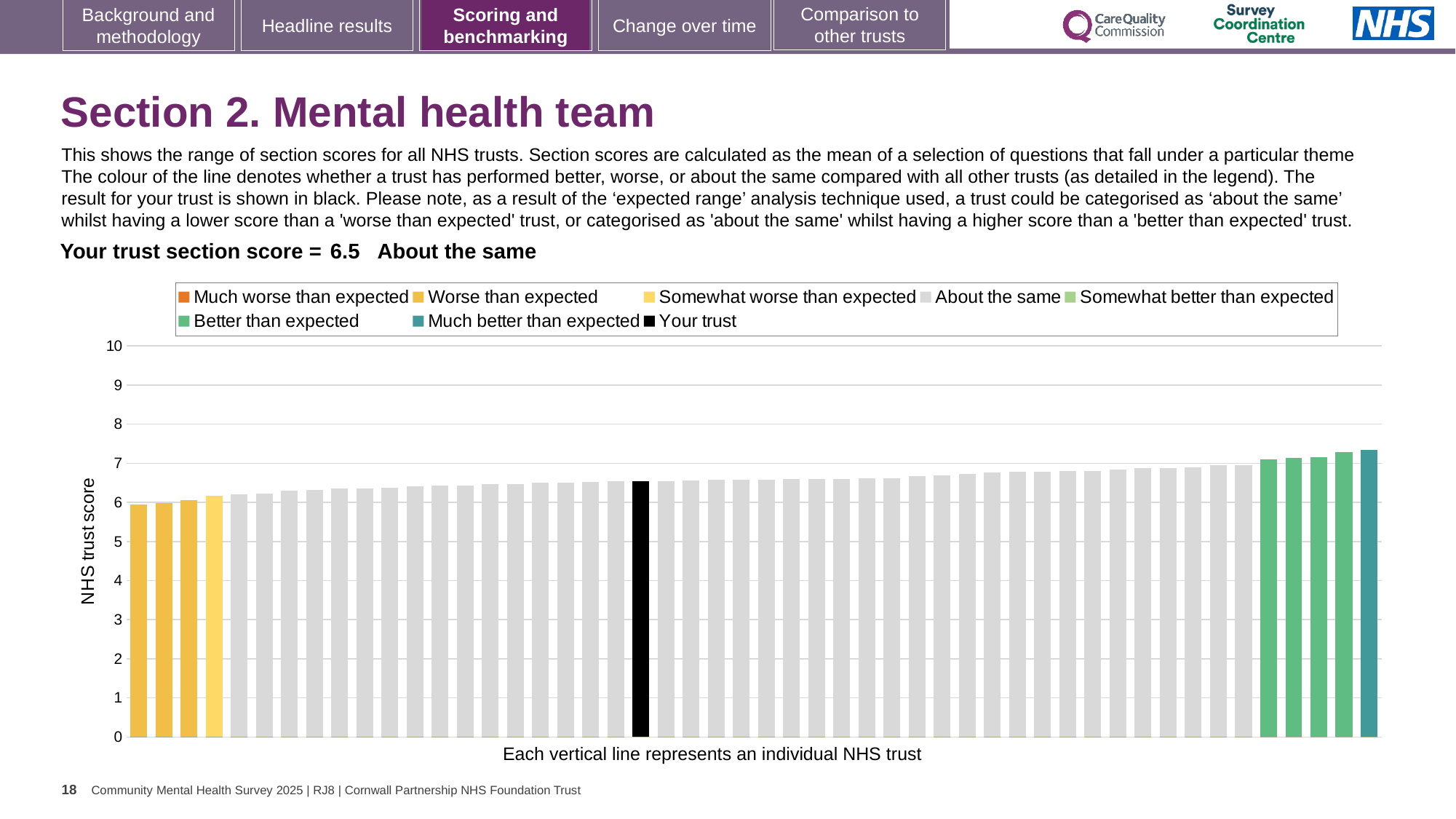
What kind of chart is shown on the slide? bar chart Is the value of the shortest bar (leftmost) greater or less than 5? greater Is the value of the black bar for your trust greater or less than 7? less Is the value of the shortest bar (leftmost) greater or less than 7? less How many entries does the chart legend list? 8 What is the section score for your trust shown on the slide? 6.5 What is the label on the vertical axis of the chart? NHS trust score Which category is your trust's section score placed in? About the same Do the bar values rise or fall from left to right along the x axis? rise